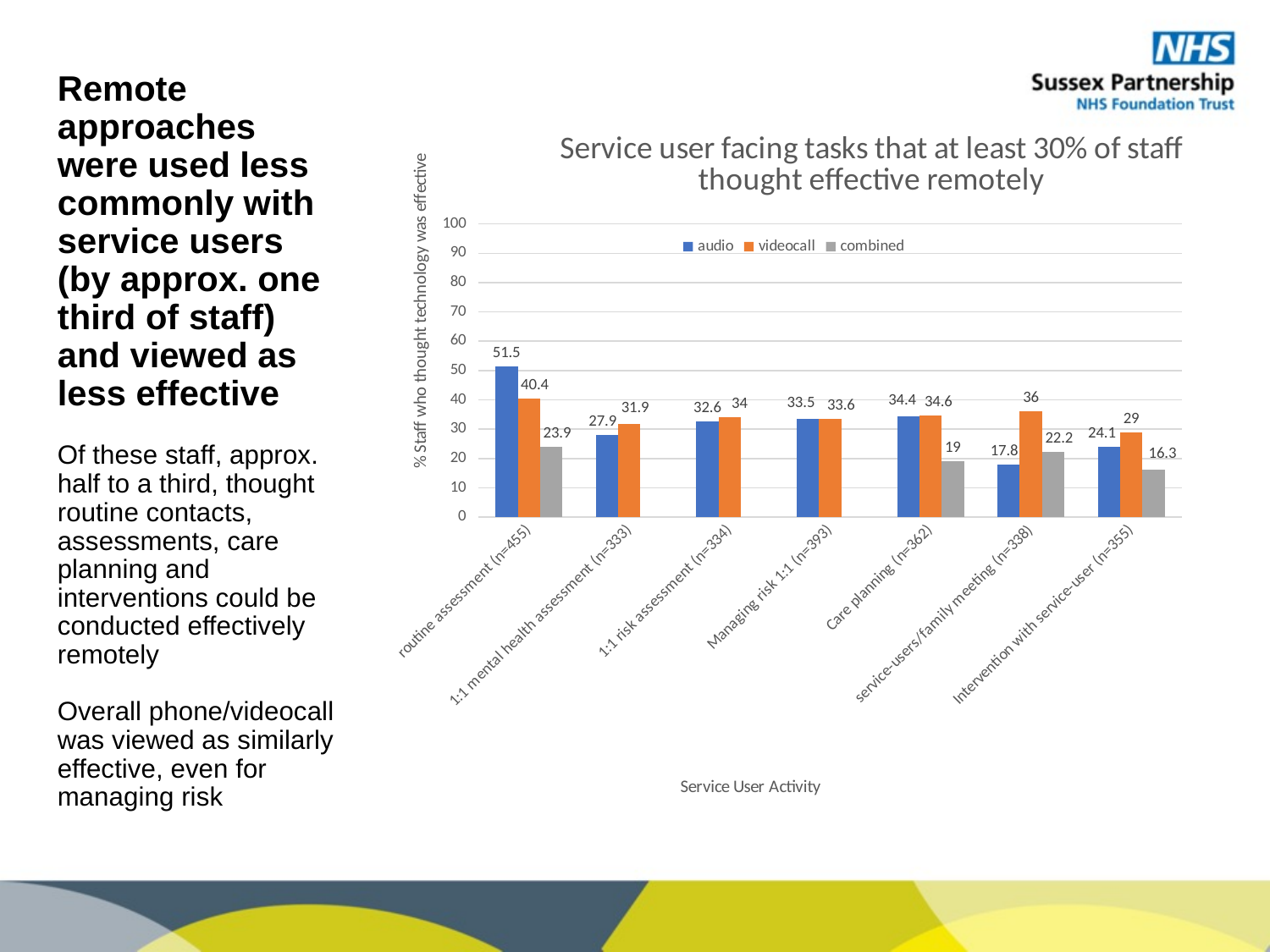
How many categories are shown on the x axis? 7 How many series does the legend list? 3 What is the difference between the audio and videocall values for routine assessment (n=455)? 11.1 Which category has the lowest audio value? service-users/family meeting (n=338) Which is larger for 1:1 mental health assessment (n=333): the audio value or the videocall value? videocall What is the difference between the videocall and audio values for service-users/family meeting (n=338)? 18.2 What is the videocall value for service-users/family meeting (n=338)? 36 Which category has the highest audio value? routine assessment (n=455) What is the title of the chart? Service user facing tasks that at least 30% of staff thought effective remotely What kind of chart is shown on the slide? bar chart What is the combined value for Intervention with service-user (n=355)? 16.3 What is the audio value for routine assessment (n=455)? 51.5